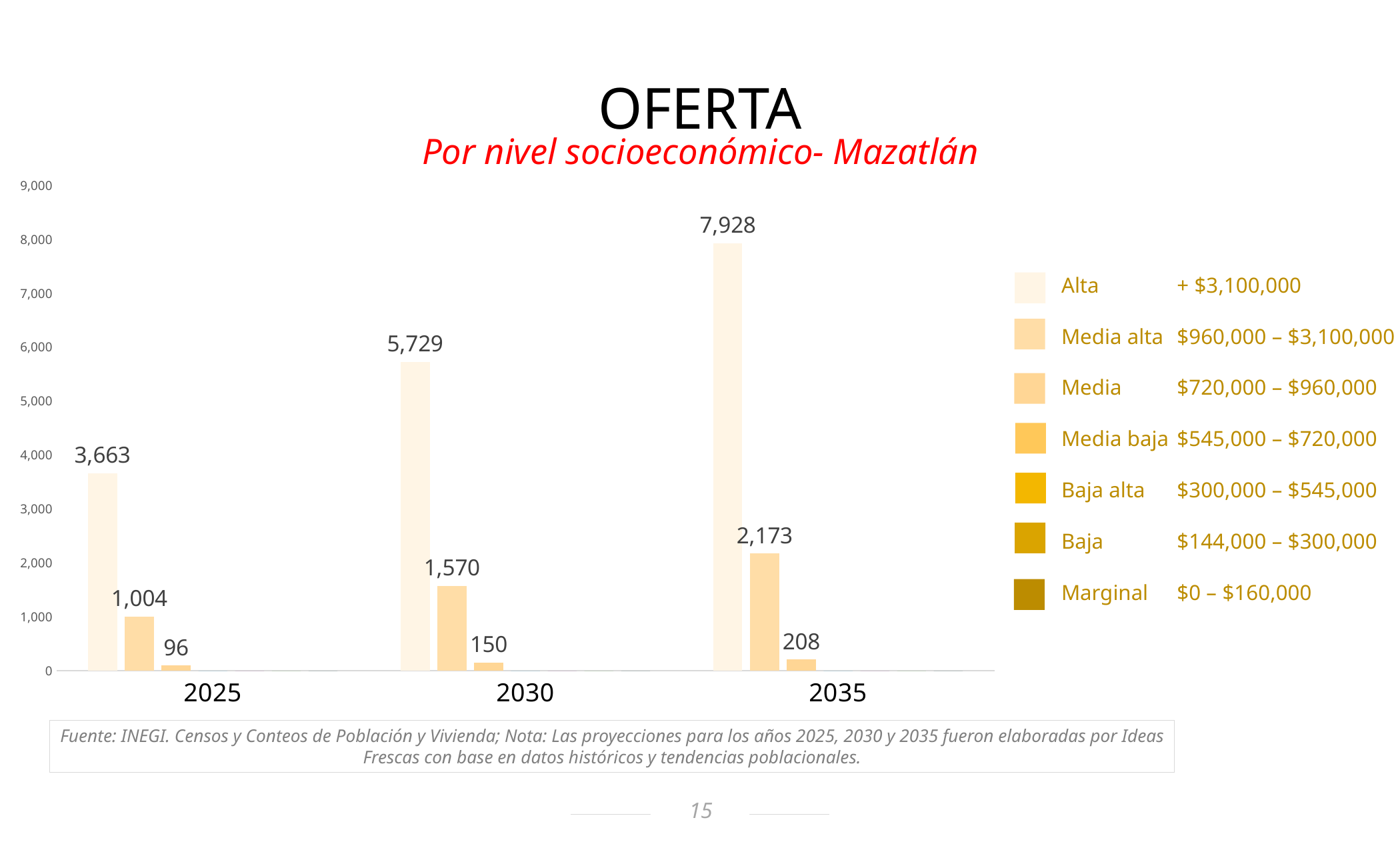
In which year is the Media value lowest? 2025 In which year is the Alta value highest? 2035 What is the difference between the Alta values for 2035 and 2030? 2,199 What is the value for Alta in 2035? 7,928 Is the value for Alta in 2030 greater or less than 5,000? greater What is the value for Media alta in 2030? 1,570 What is the value for Alta in 2025? 3,663 What is the value for Media in 2025? 96 How many years are shown on the x axis? 3 Does the Alta value rise or fall from 2025 to 2035? rise How many series does the legend list? 7 Which is larger: Media alta in 2035 or Media alta in 2025? Media alta in 2035